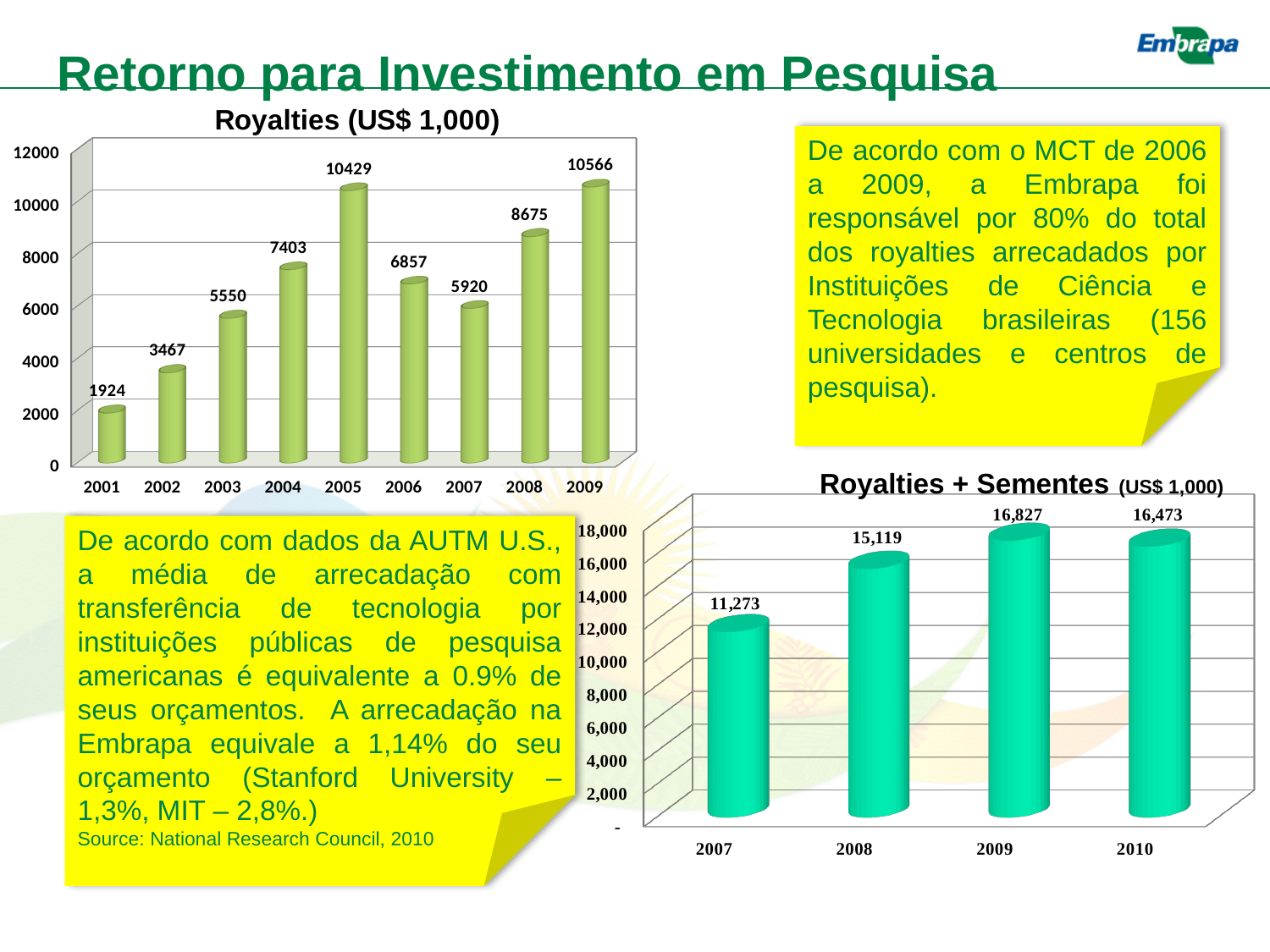
How many years are shown in the 'Royalties (US$ 1,000)' chart? 9 What kind of chart is the 'Royalties (US$ 1,000)' chart? Bar chart In the 'Royalties + Sementes (US$ 1,000)' chart, what is the difference between the values for 2008 and 2007? 3,846 In the 'Royalties (US$ 1,000)' chart, which year has the highest value? 2009 In the 'Royalties (US$ 1,000)' chart, which is larger, the value for 2006 or the value for 2007? 2006 In the 'Royalties (US$ 1,000)' chart, which year has the lowest value? 2001 In the 'Royalties (US$ 1,000)' chart, what is the value for 2001? 1924 In the 'Royalties + Sementes (US$ 1,000)' chart, which year has the highest value? 2009 In the 'Royalties + Sementes (US$ 1,000)' chart, what is the value for 2008? 15,119 In the 'Royalties (US$ 1,000)' chart, what is the difference between the values for 2009 and 2008? 1891 In the 'Royalties (US$ 1,000)' chart, what is the value for 2005? 10429 How many years are shown in the 'Royalties + Sementes (US$ 1,000)' chart? 4